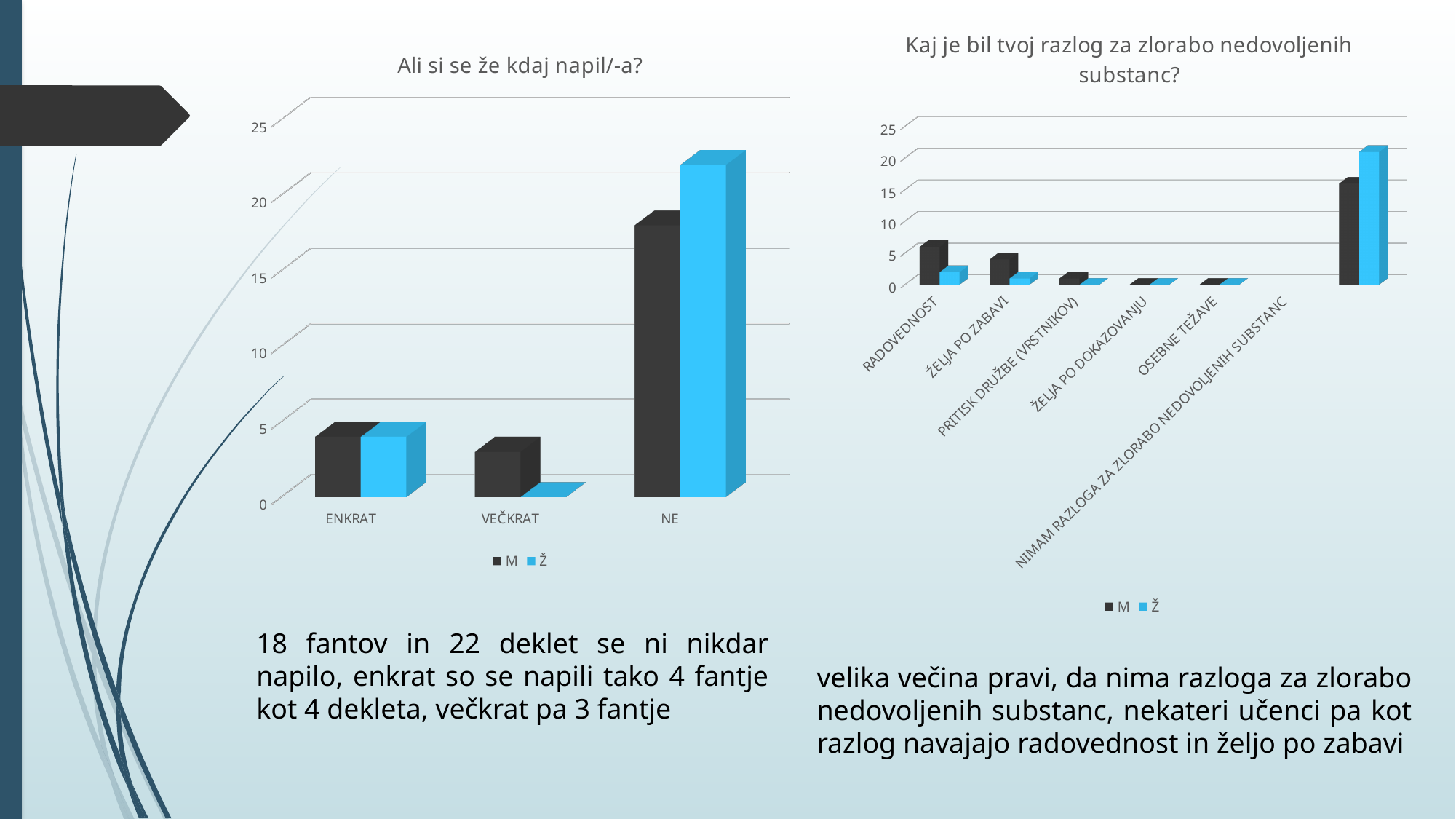
In the chart titled "Ali si se že kdaj napil/-a?", is the M value for VEČKRAT greater or less than 5? less In the chart titled "Kaj je bil tvoj razlog za zlorabo nedovoljenih substanc?", what are the two legend entries? M and Ž In the chart titled "Ali si se že kdaj napil/-a?", which category has the highest value for the M series? NE In the chart titled "Kaj je bil tvoj razlog za zlorabo nedovoljenih substanc?", which category has the highest value for the Ž series? NIMAM RAZLOGA ZA ZLORABO NEDOVOLJENIH SUBSTANC In the chart titled "Ali si se že kdaj napil/-a?", is the Ž value for NE greater or less than 20? greater In the chart titled "Kaj je bil tvoj razlog za zlorabo nedovoljenih substanc?", how many categories are shown on the x axis? 6 In the chart titled "Ali si se že kdaj napil/-a?", how many series does the legend list? 2 In the chart titled "Kaj je bil tvoj razlog za zlorabo nedovoljenih substanc?", which series has the larger value for RADOVEDNOST, M or Ž? M In the chart titled "Kaj je bil tvoj razlog za zlorabo nedovoljenih substanc?", is the M value for RADOVEDNOST greater or less than 10? less What kind of chart is the chart titled "Ali si se že kdaj napil/-a?"? bar chart In the chart titled "Ali si se že kdaj napil/-a?", how many categories are shown on the x axis? 3 In the chart titled "Ali si se že kdaj napil/-a?", which series has the larger value for NE, M or Ž? Ž